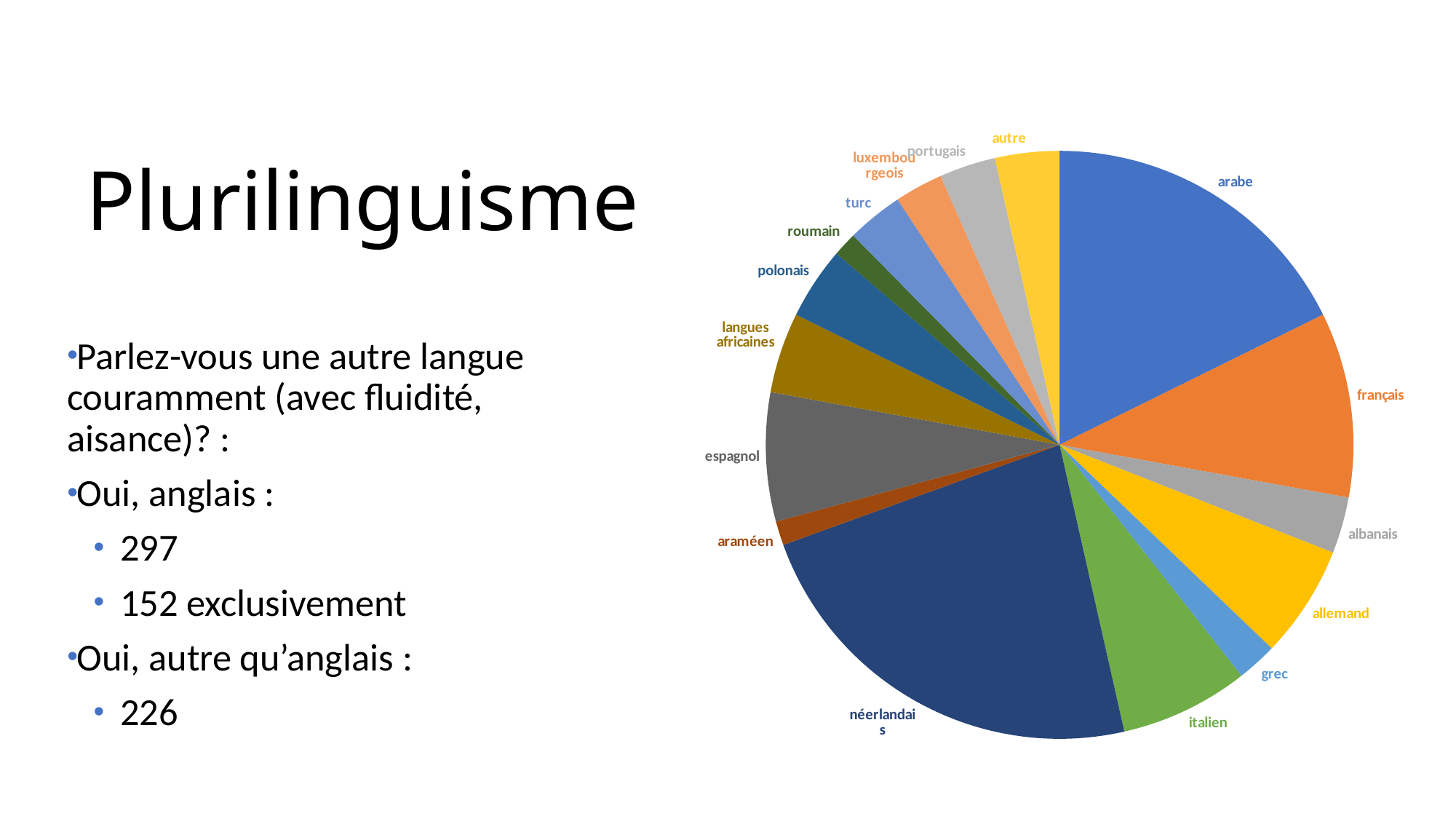
Which slice is larger, français or albanais? français Which language has the largest slice of the pie chart? néerlandais Which slice is larger, italien or grec? italien Which slice is larger, langues africaines or roumain? langues africaines What colour is the néerlandais slice of the pie chart? dark blue What kind of chart is shown on the slide? pie chart How many slices does the pie chart have? 16 What colour is the français slice of the pie chart? orange